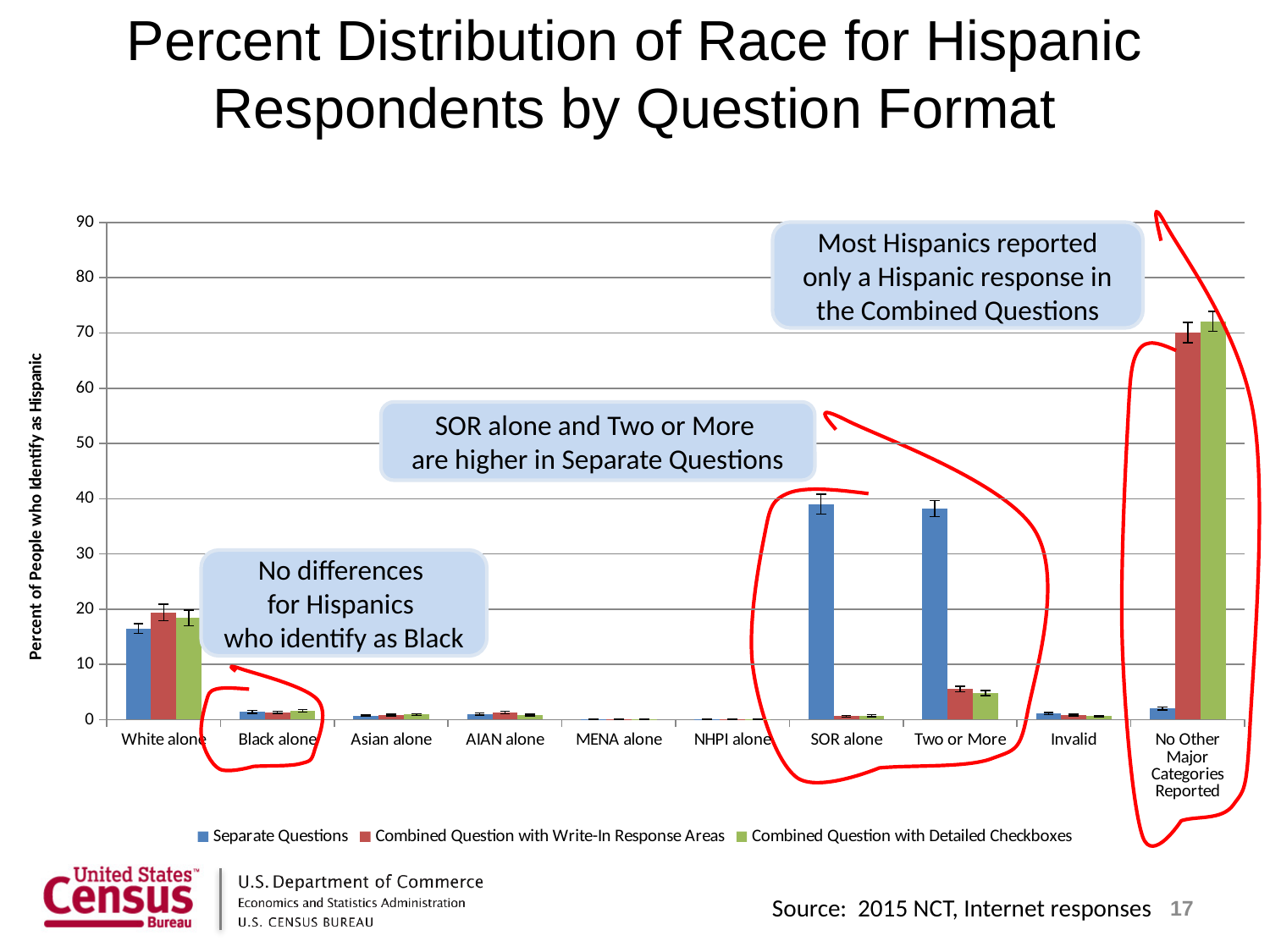
Is the Combined Question with Write-In Response Areas value for Two or More greater or less than 10? less What kind of chart is shown on the slide? bar chart How many series does the legend list? 3 Which category has the highest Combined Question with Detailed Checkboxes value? No Other Major Categories Reported Is the Separate Questions value for SOR alone greater or less than 30? greater Is the Combined Question with Write-In Response Areas value for No Other Major Categories Reported greater or less than 60? greater What is the label on the y axis? Percent of People who Identify as Hispanic For SOR alone, which series has the highest value? Separate Questions How many race categories are shown along the x axis? 10 What is the title of the chart? Percent Distribution of Race for Hispanic Respondents by Question Format For Two or More, which is larger: Separate Questions or Combined Question with Detailed Checkboxes? Separate Questions